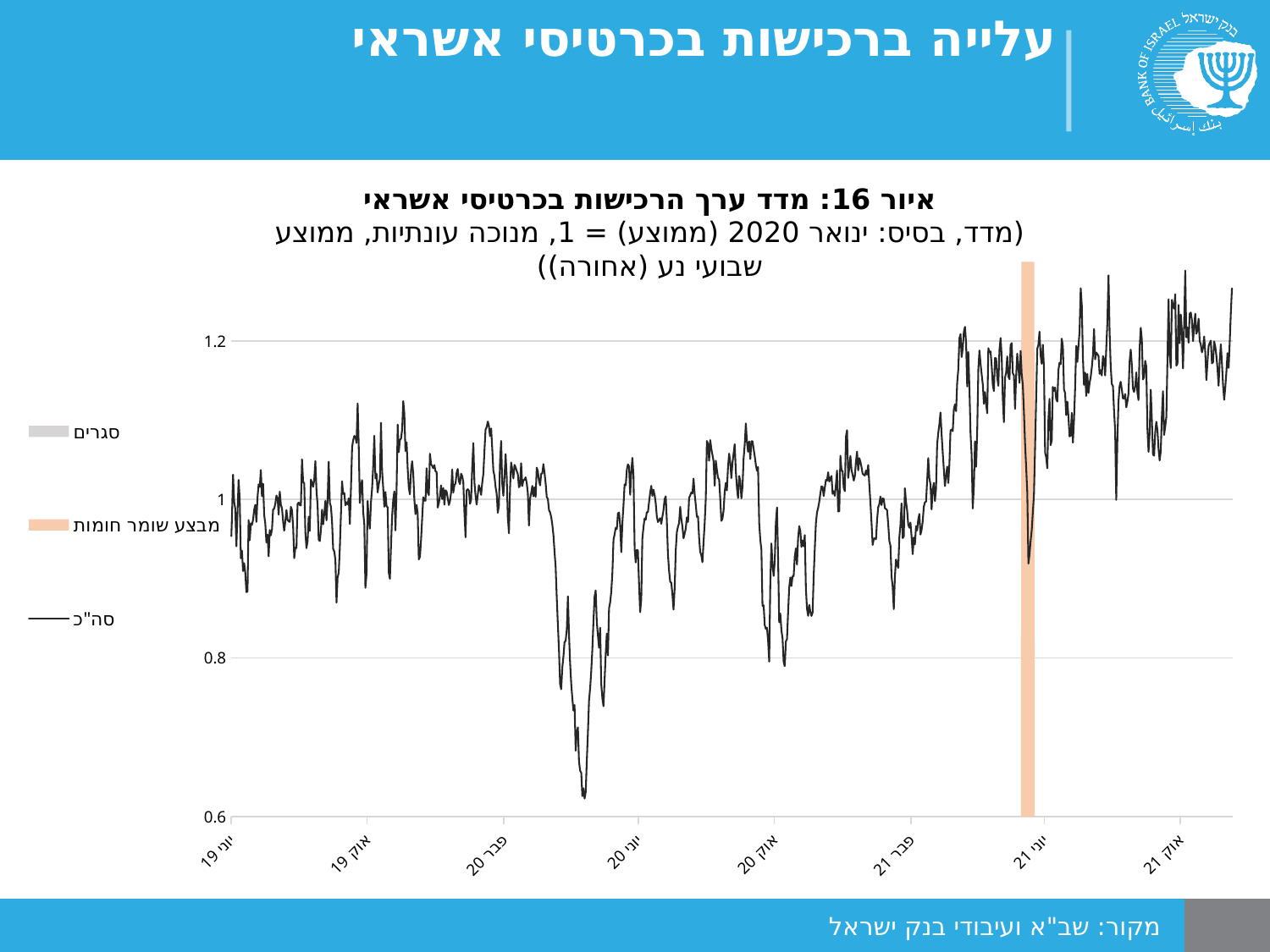
Is the highest point of the סה"כ line greater or less than 1.2? greater What is the highest value shown on the y axis? 1.2 Is the lowest point of the סה"כ line greater or less than 0.8? less Is the value of the סה"כ line at יוני 21 greater or less than 1? greater How many entries does the legend list? 3 What colour is the legend entry for מבצע שומר חומות? orange How many labelled tick marks are there on the x axis? 8 Between which two x-axis labels does the סה"כ line reach its lowest point? פבר 20 and יוני 20 What kind of chart is shown on the slide? line chart Does the סה"כ line overall rise or fall from יוני 19 to אוק 21? rise